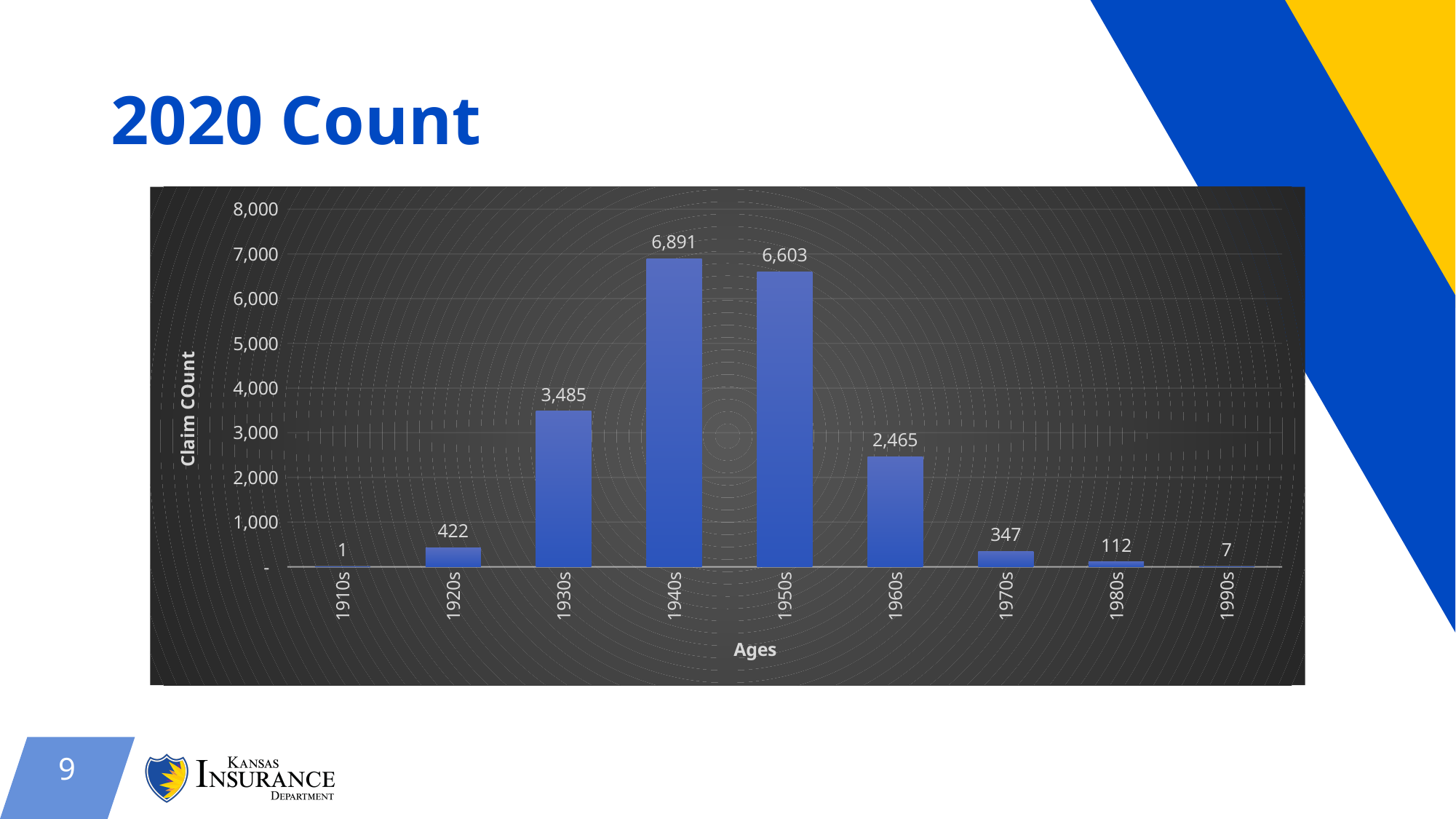
Is the claim count for the 1930s age group greater or less than 3,000? greater How many age groups are shown on the x axis? 9 What is the difference in claim count between the 1930s and 1960s age groups? 1,020 What is the claim count for the 1980s age group? 112 What is the difference in claim count between the 1940s and 1950s age groups? 288 What is the claim count for the 1920s age group? 422 Which age group has the highest claim count? 1940s What kind of chart is shown on the slide? bar chart Which has a higher claim count, the 1970s or the 1990s age group? 1970s What is the label of the vertical axis? Claim COunt Which age group has the lowest claim count? 1910s What is the claim count for the 1940s age group? 6,891